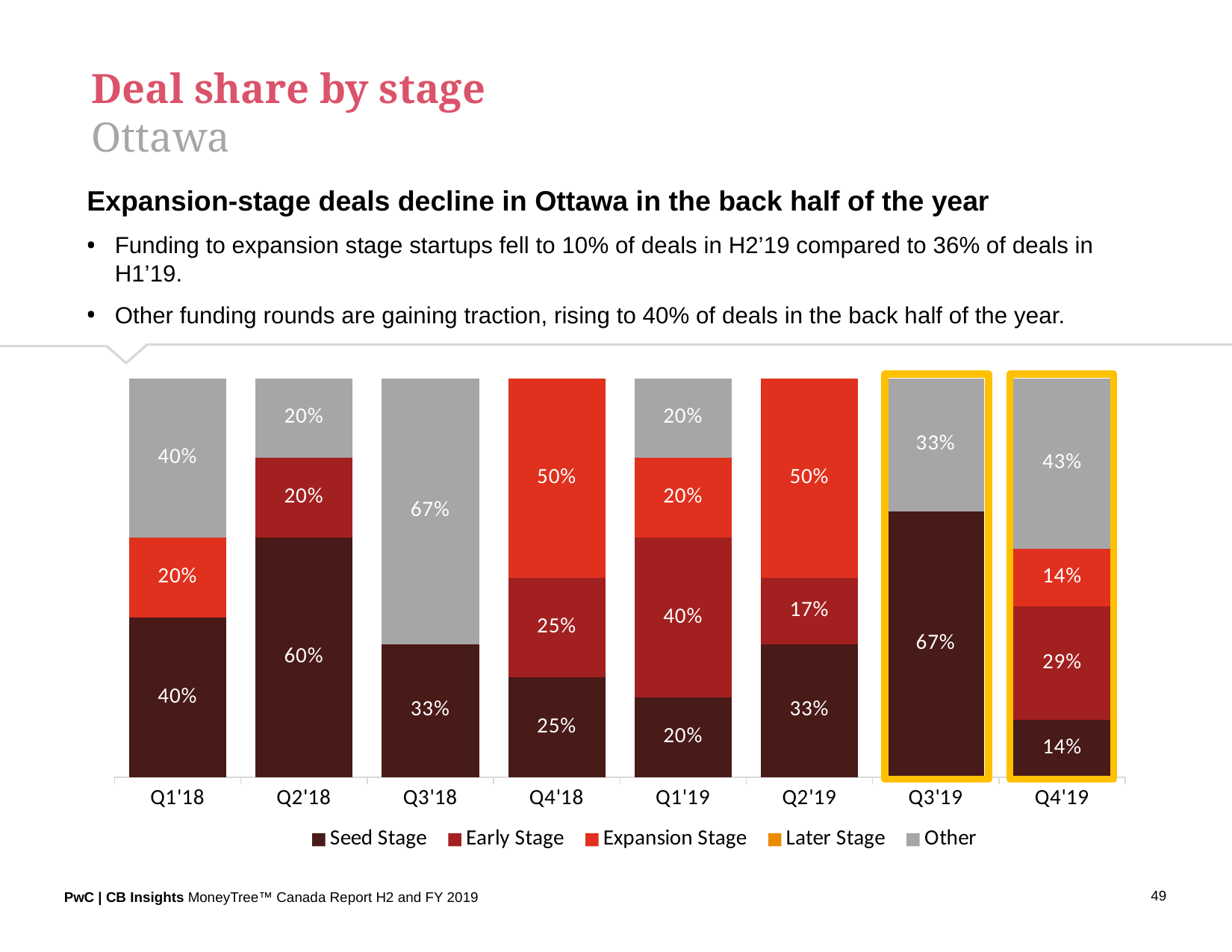
What kind of chart is shown on the slide? Stacked bar chart Which quarters are highlighted with a yellow outline? Q3'19 and Q4'19 How many quarters are shown on the x axis? 8 What is the Other share of deals in Q4'19? 43% How many percentage points higher is the Other share in Q3'18 than in Q1'18? 27 percentage points What is the Early Stage share of deals in Q2'19? 17% What is the Seed Stage share of deals in Q2'18? 60% Which quarter has the highest Seed Stage share? Q3'19 Which quarter has the larger Early Stage share, Q1'19 or Q4'19? Q1'19 What is the Expansion Stage share of deals in Q4'18? 50% Which quarter has the lowest Seed Stage share? Q4'19 How many series does the legend list? 5